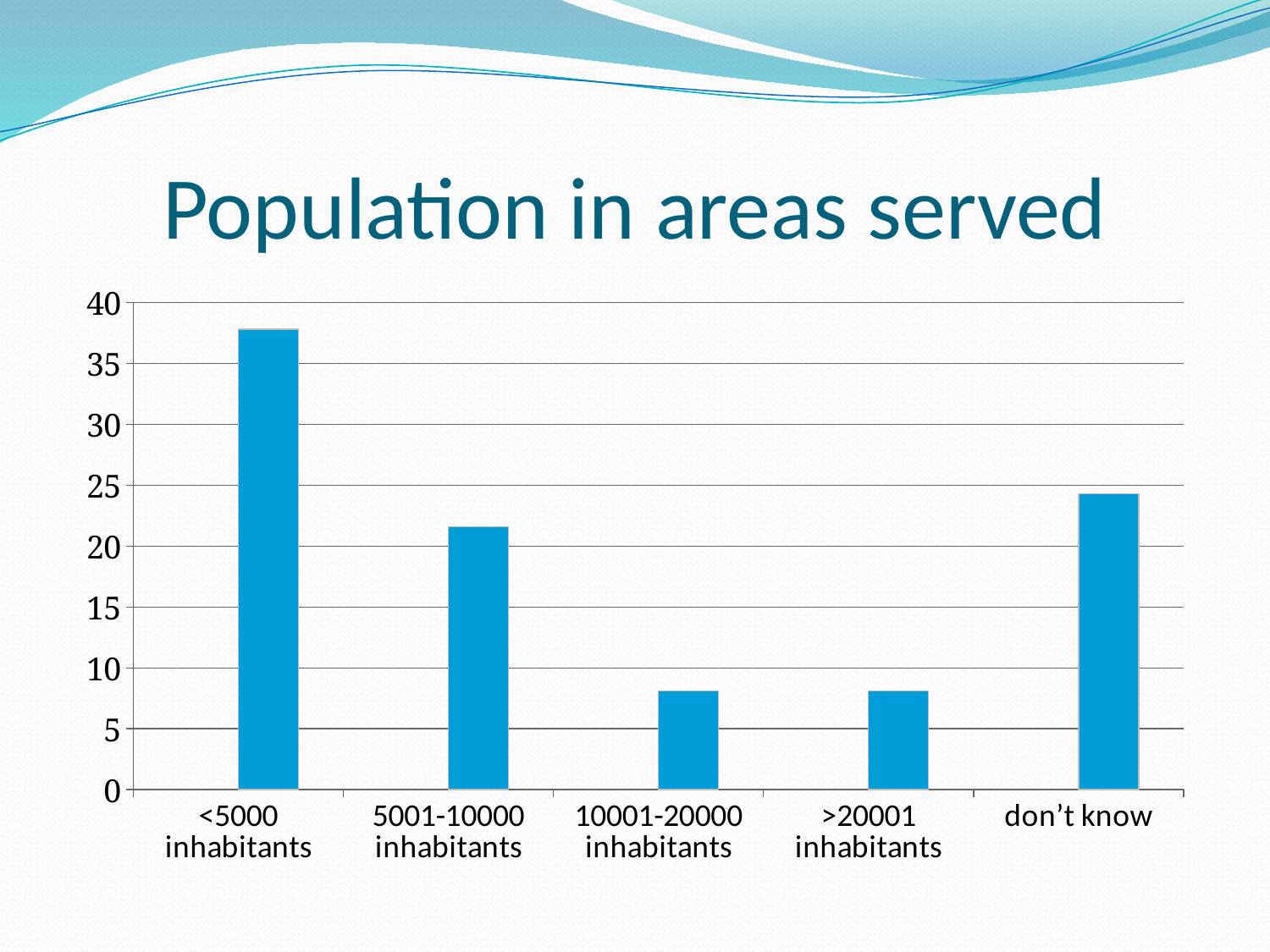
Is the value for <5000 inhabitants greater or less than 35? greater How many categories are shown on the x axis? 5 Which is larger, the value for 5001-10000 inhabitants or the value for don't know? don't know Is the value for don't know greater or less than 25? less Which category has the highest value? <5000 inhabitants Is the value for 10001-20000 inhabitants greater or less than 10? less What kind of chart is shown on the slide? bar chart What is the title of the chart? Population in areas served Which is larger, the value for <5000 inhabitants or the value for don't know? <5000 inhabitants What is the highest value shown on the vertical axis? 40